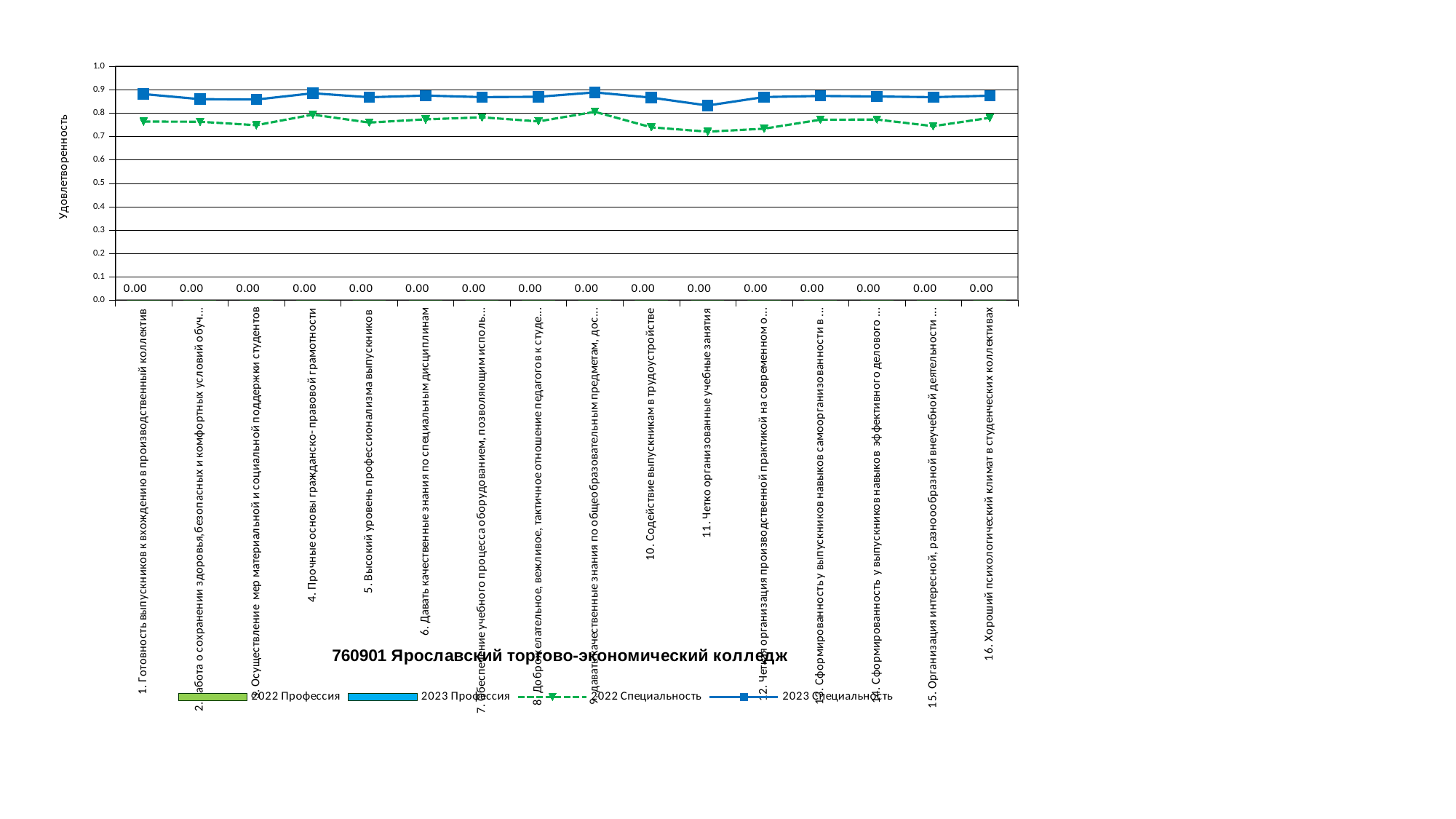
Is the value of the 2023 Специальность series for category "11. Четко организованные учебные занятия" greater or less than 0.9? less How many series does the legend list? 4 For category "10. Содействие выпускникам в трудоустройстве", which series has the larger value: 2022 Специальность or 2023 Специальность? 2023 Специальность What value is printed for the bar series at category "1. Готовность выпускников к вхождению в производственный коллектив"? 0.00 For which category is the 2023 Специальность series lowest? 11. Четко организованные учебные занятия Which series is drawn as a dashed green line with triangle markers? 2022 Специальность What is the title of the chart? 760901 Ярославский торгово-экономический колледж What value is printed for the bar series at category "11. Четко организованные учебные занятия"? 0.00 Is the value of the 2023 Специальность series for category "1. Готовность выпускников к вхождению в производственный коллектив" greater or less than 0.8? greater Is the value of the 2022 Специальность series for category "11. Четко организованные учебные занятия" greater or less than 0.8? less How many categories are shown along the x axis? 16 What is the label of the vertical axis? Удовлетворенность